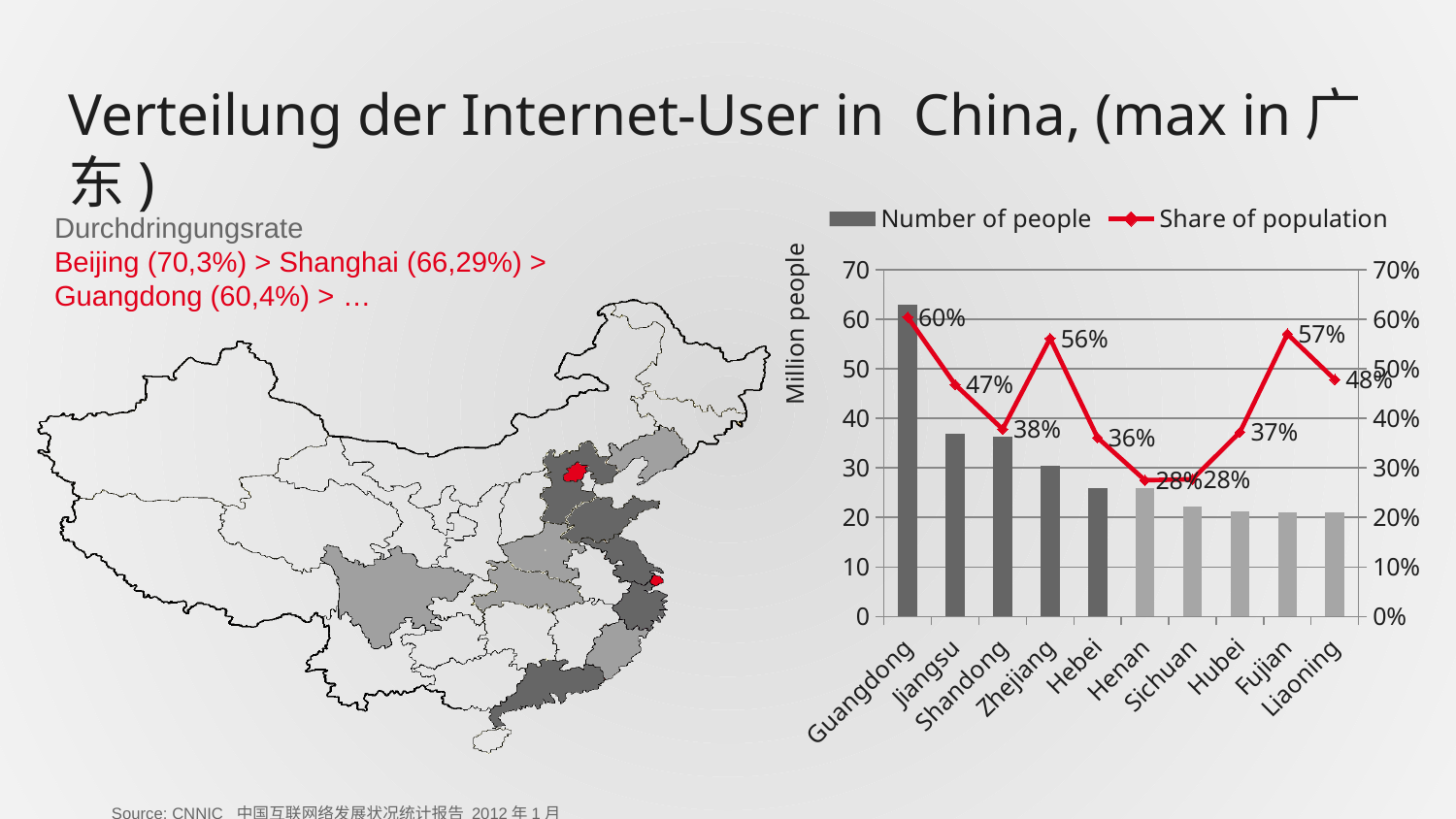
Which has a higher Share of population, Zhejiang or Fujian? Fujian How many series does the chart legend list? 2 What is the Share of population for Fujian? 57% Is the Number of people value for Liaoning greater or less than 30? less What is the Share of population for Guangdong? 60% How many provinces are shown on the x axis of the chart? 10 Is the Number of people value for Guangdong greater or less than 60? greater What kind of chart is shown on the right of the slide? A bar chart combined with a line chart What is the Share of population for Zhejiang? 56% Which province has the tallest Number of people bar? Guangdong What is the difference between the Share of population for Guangdong and for Jiangsu? 13% Which province has the highest Share of population? Guangdong